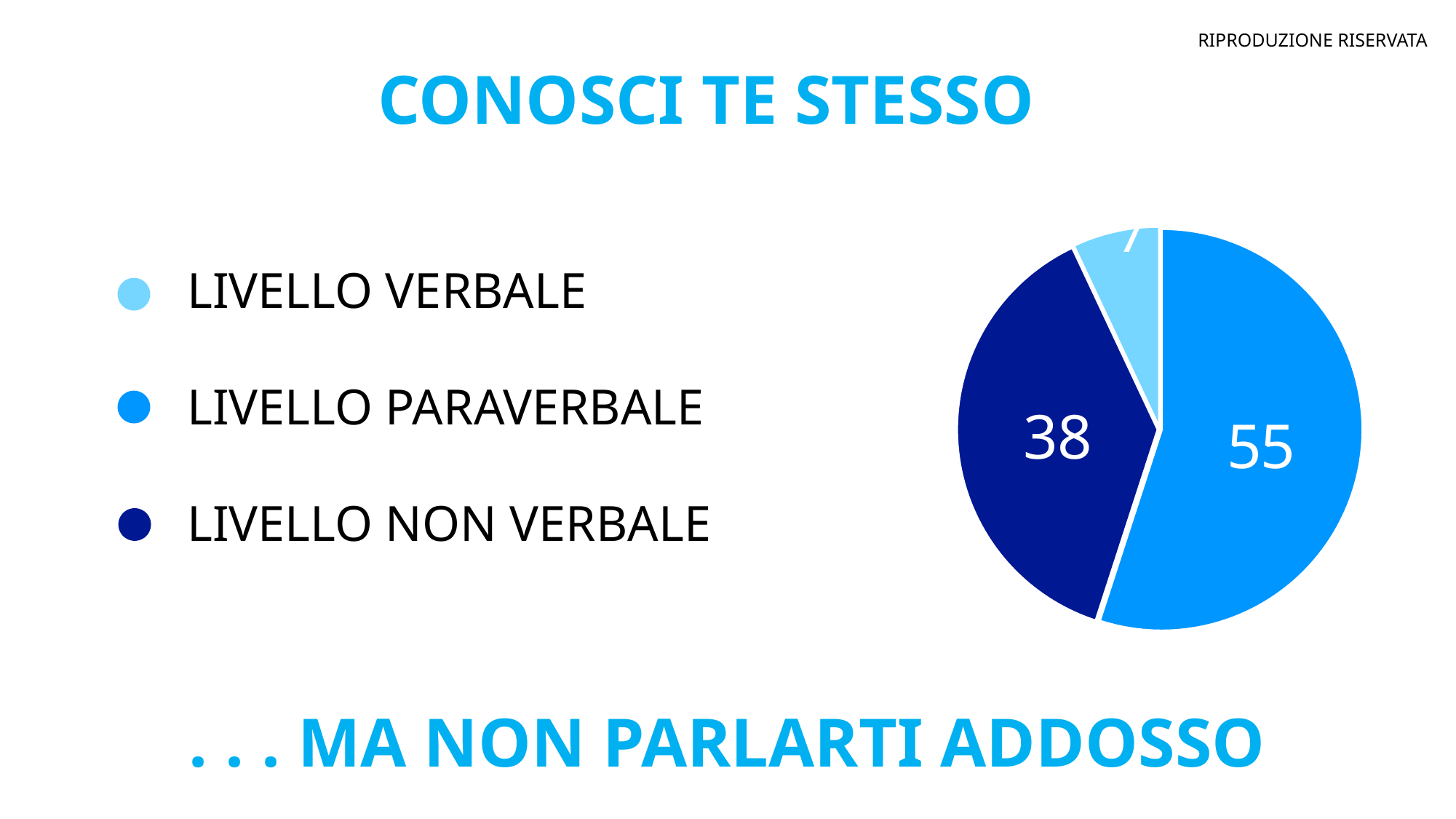
Which is larger, the slice for LIVELLO PARAVERBALE or the slice for LIVELLO NON VERBALE? LIVELLO PARAVERBALE What kind of chart is shown on the slide? pie chart What is the difference between the values for LIVELLO PARAVERBALE and LIVELLO NON VERBALE? 17 What value is shown for LIVELLO NON VERBALE in the pie chart? 38 Which category has the smallest slice of the pie chart? LIVELLO VERBALE What value is shown for LIVELLO PARAVERBALE in the pie chart? 55 What colour is the slice for LIVELLO NON VERBALE? dark blue Which category is shown in light blue in the pie chart? LIVELLO VERBALE Which category has the largest slice of the pie chart? LIVELLO PARAVERBALE Which is larger, the slice for LIVELLO VERBALE or the slice for LIVELLO NON VERBALE? LIVELLO NON VERBALE How many slices does the pie chart have? 3